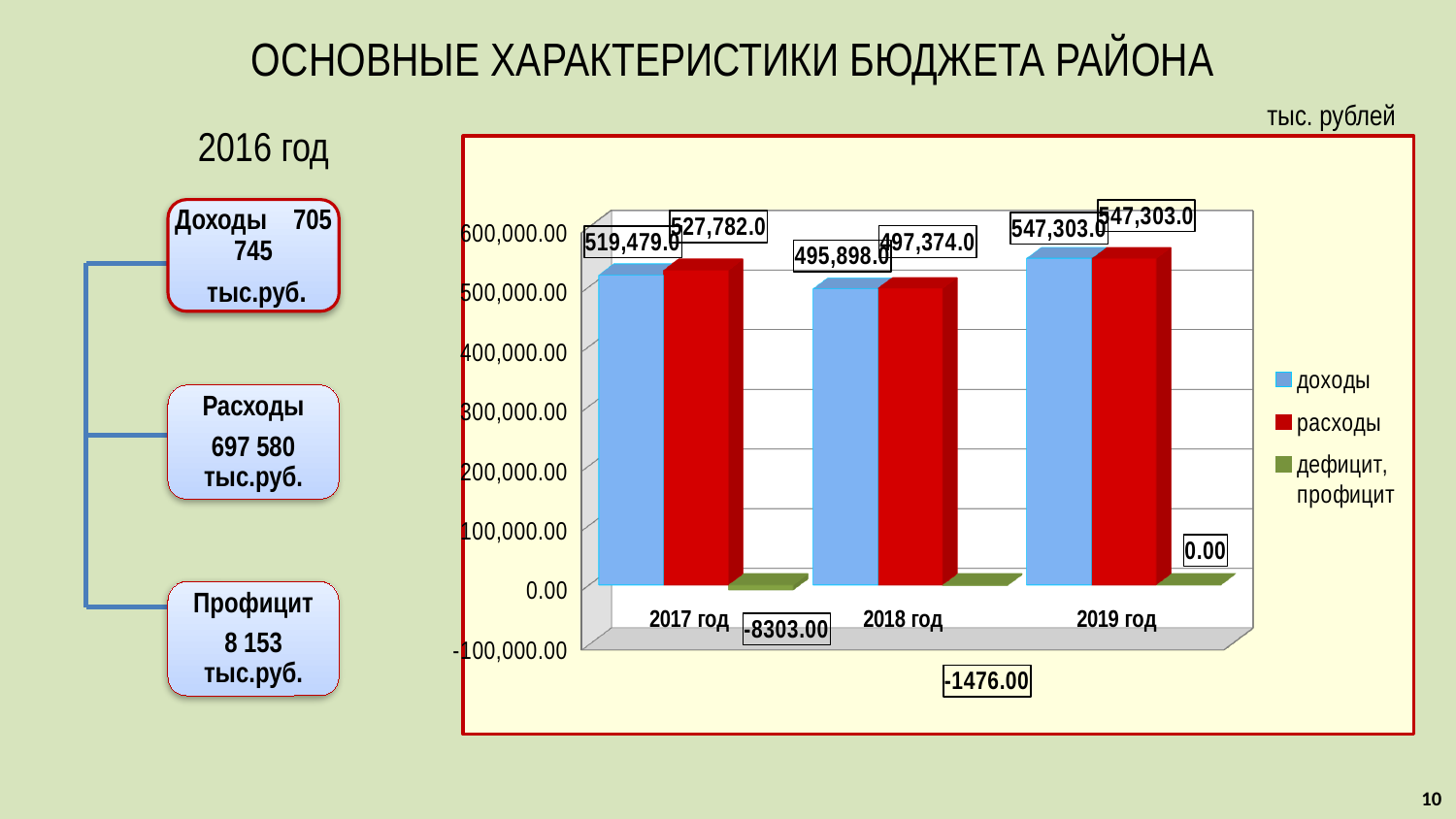
What is the value of расходы for 2018 год? 497,374.0 What is the value of доходы for 2017 год? 519,479.0 Is the value of доходы for 2018 год greater or less than 500,000.00? less In which year is расходы the lowest? 2018 год How many years are shown on the x axis? 3 Which is larger for 2018 год, доходы or расходы? расходы What is the difference between расходы and доходы for 2017 год? 8,303.0 What is the value of дефицит, профицит for 2017 год? -8303.00 In which year is доходы the highest? 2019 год What is the value of дефицит, профицит for 2019 год? 0.00 How many series does the legend list? 3 What type of chart is shown? bar chart